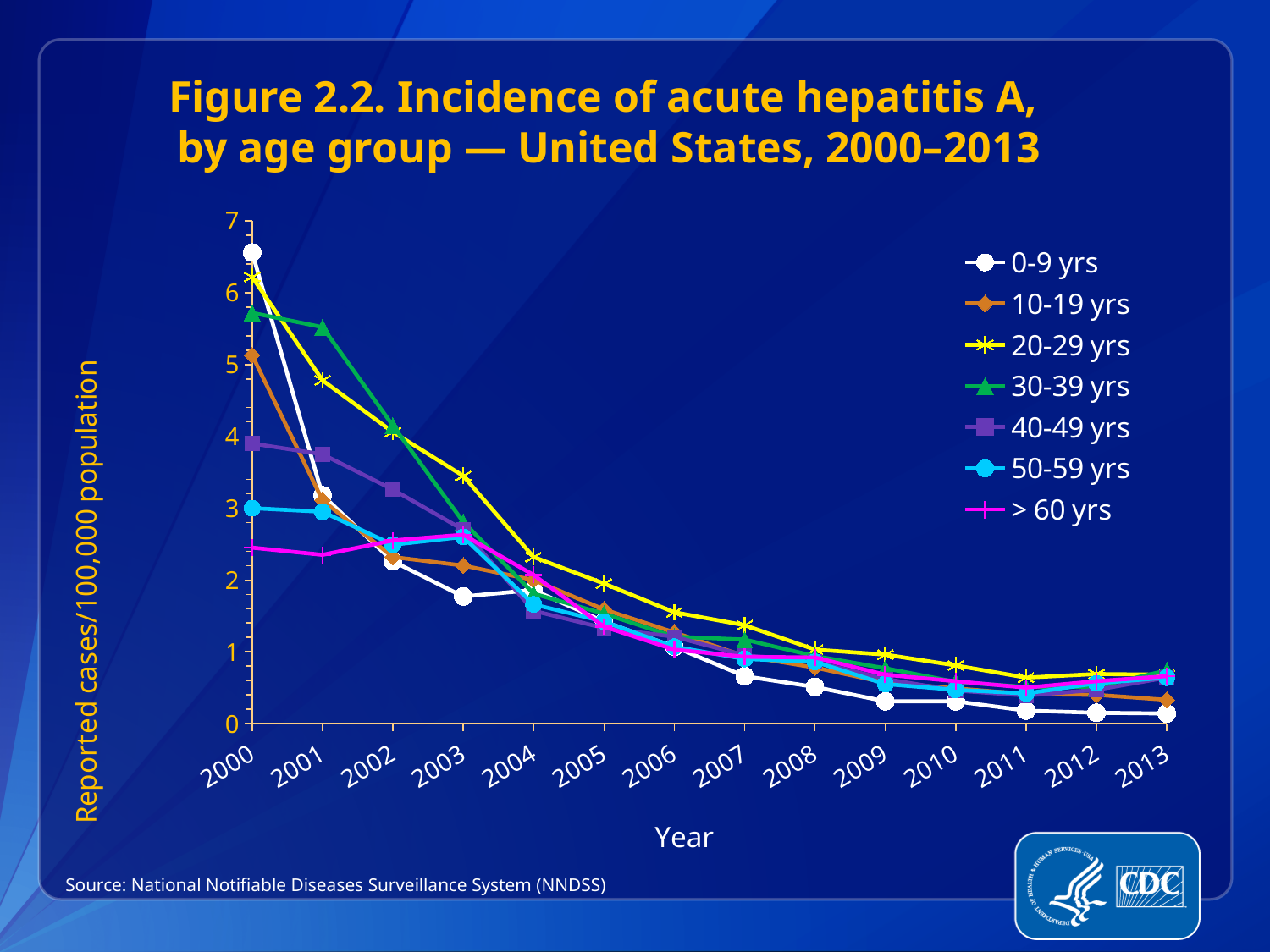
How many age-group series does the legend list? 7 What is the label on the y axis of the chart? Reported cases/100,000 population What kind of chart is shown on the slide? Line chart Which age group has the highest incidence in 2005? 20-29 yrs Does the incidence for the 0-9 yrs group rise or fall from 2000 to 2013? Fall Is the value for 0-9 yrs in 2013 greater or less than 1? less Is the value for 0-9 yrs in 2000 greater or less than 6? greater In 2000, which has the higher incidence: 10-19 yrs or 40-49 yrs? 10-19 yrs In 2001, which has the higher incidence: 30-39 yrs or 20-29 yrs? 30-39 yrs Which age group has the lowest incidence in 2013? 0-9 yrs Which age group has the lowest incidence in 2000? > 60 yrs How many years are plotted along the x axis? 14